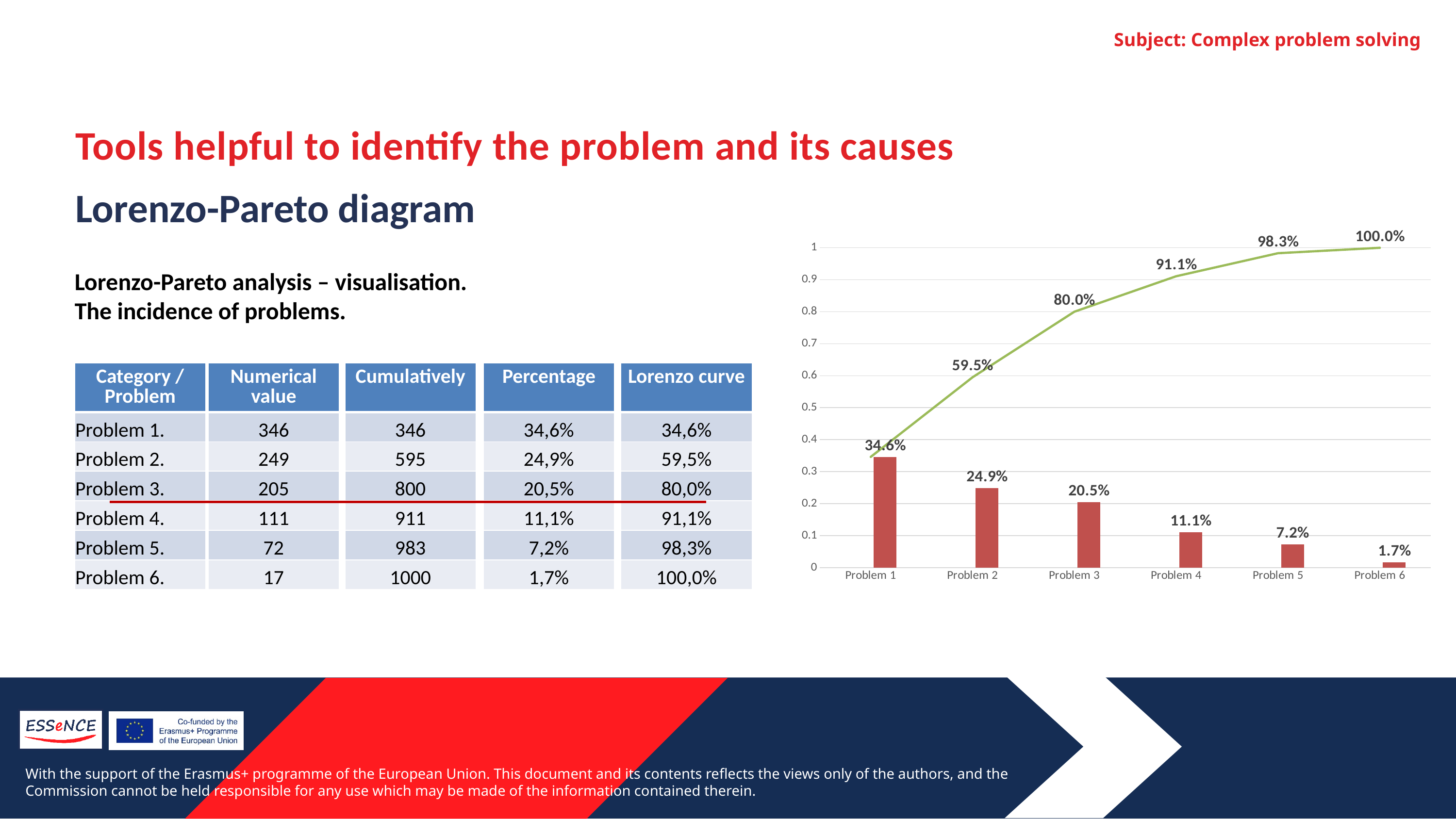
Which has the larger bar value, Problem 3 or Problem 4? Problem 3 What value does the cumulative line show at Problem 5? 98.3% What value does the cumulative line show at Problem 3? 80.0% Which problem has the highest bar? Problem 1 How many problems are shown on the x axis of the chart? 6 Do the bar values rise or fall from Problem 1 to Problem 6? fall Which problem has the lowest bar? Problem 6 What is the value shown on the bar for Problem 2? 24.9% Is the bar for Problem 1 greater or less than 0.3 on the axis? greater Does the line rise or fall from Problem 1 to Problem 6? rise What is the difference between the bar values for Problem 1 and Problem 2? 9.7% What colour is the cumulative line in the chart? green